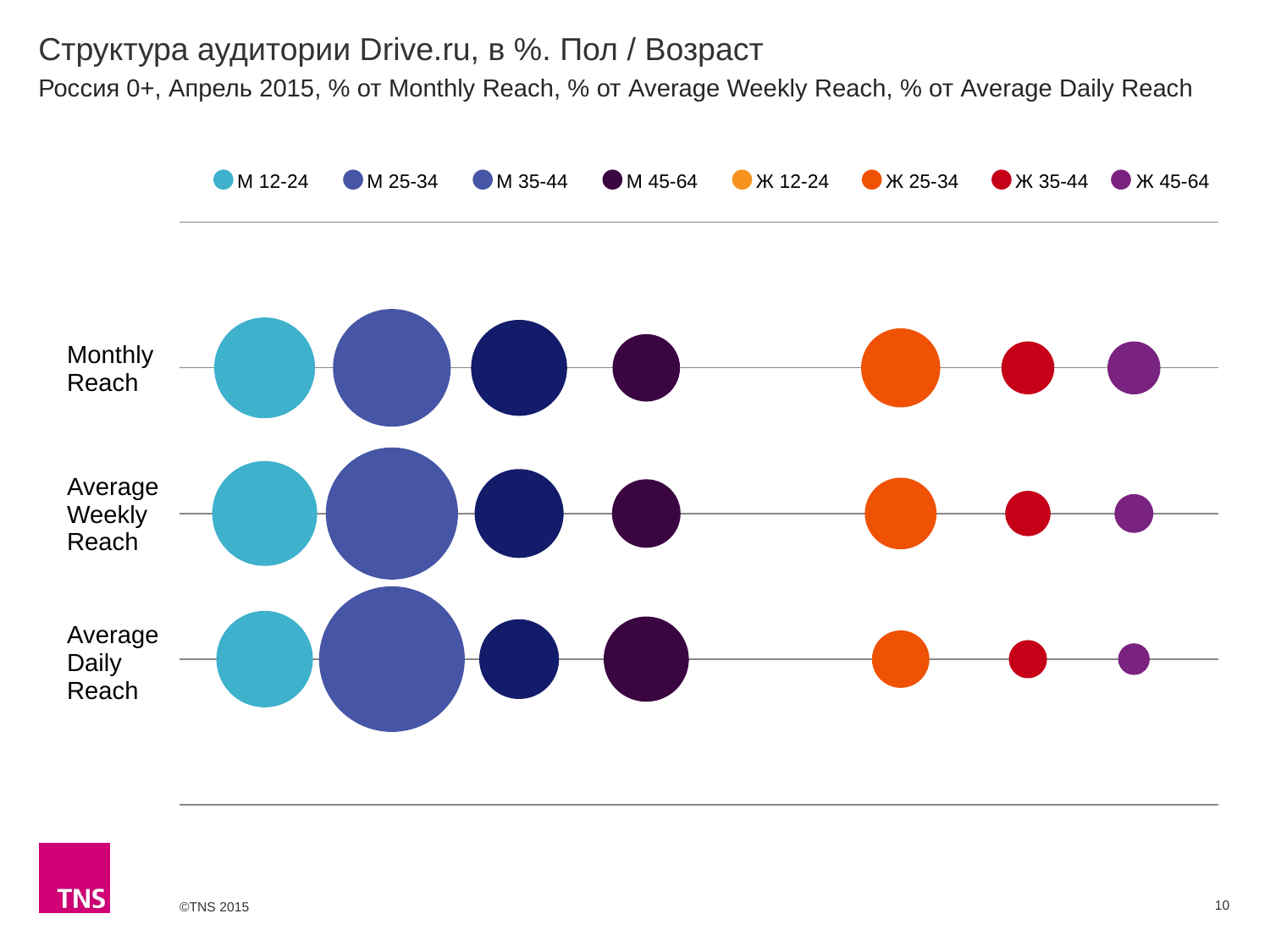
In the Average Daily Reach row, which bubble is larger: М 45-64 or М 35-44? М 45-64 What is the title of the slide? Структура аудитории Drive.ru, в %. Пол / Возраст Which series has the largest bubble in the Average Daily Reach row? М 25-34 In the Monthly Reach row, which bubble is larger: М 12-24 or Ж 35-44? М 12-24 Which series has the largest bubble in the Monthly Reach row? М 25-34 Which legend series is shown with an orange-yellow marker? Ж 12-24 Which series has the smallest bubble in the Average Daily Reach row? Ж 45-64 Which series has the smallest bubble in the Average Weekly Reach row? Ж 45-64 What kind of chart is shown on the slide? Bubble chart How many series does the legend list? 8 How many reach categories (rows) are plotted on the chart? 3